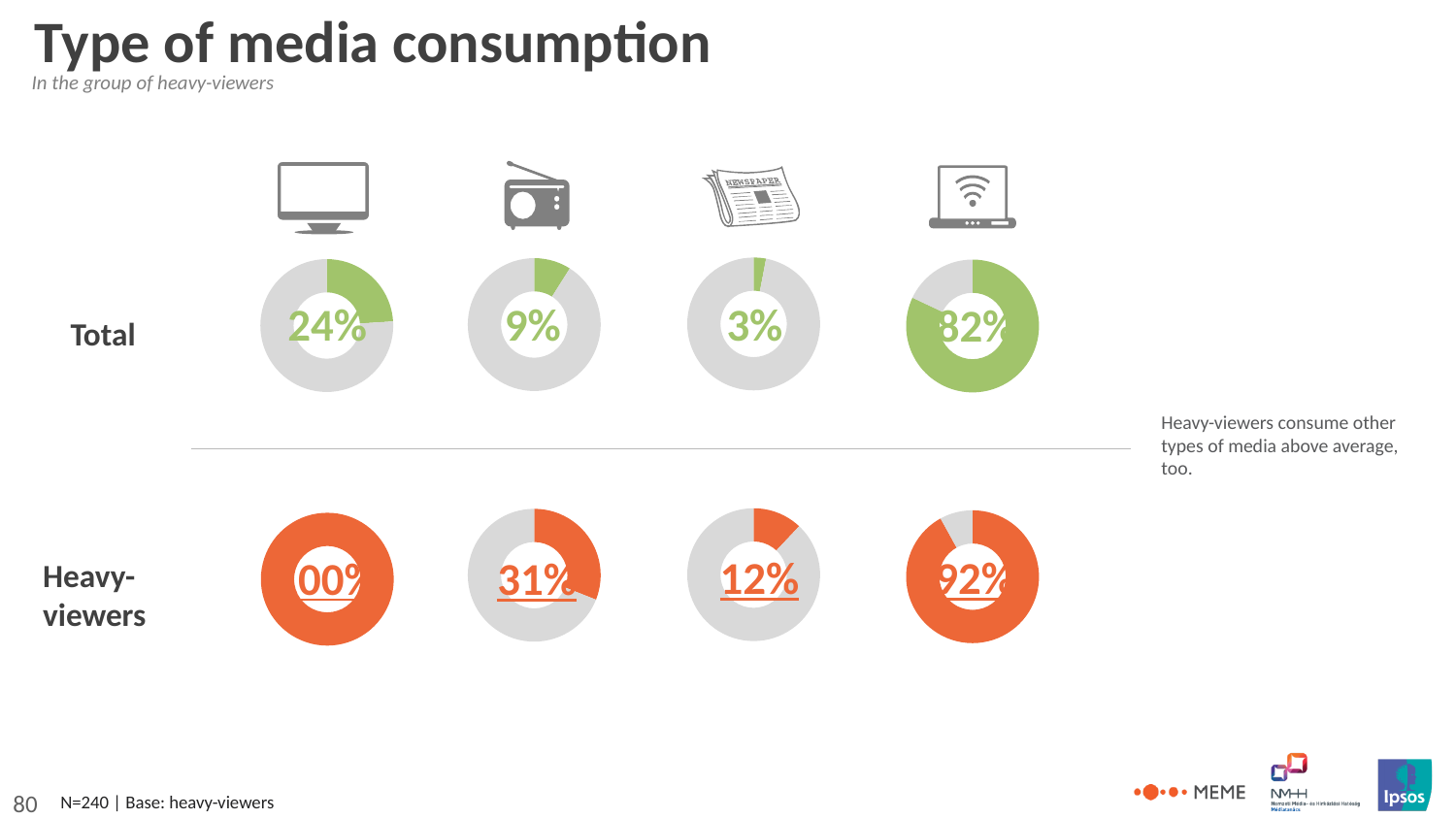
In the Total row, what percentage is shown in the donut chart under the newspaper icon? 3% In the Total row, what percentage is shown in the donut chart under the TV icon? 24% What is the difference between the Heavy-viewers and Total percentages for the laptop (internet) icon? 10 percentage points In the Total row, what percentage is shown in the donut chart under the radio icon? 9% In the Total row, what percentage is shown in the donut chart under the laptop (internet) icon? 82% In the Heavy-viewers row, what percentage is shown in the donut chart under the laptop (internet) icon? 92% In the Total row, which media type has the lowest percentage? Newspaper What is the difference between the Heavy-viewers and Total percentages for radio? 22 percentage points In the Total row, which media type has the highest percentage? Internet (laptop) What kind of chart is used to show each percentage on the slide? Donut (pie) chart In the Heavy-viewers row, what percentage is shown in the donut chart under the newspaper icon? 12% In the Heavy-viewers row, what percentage is shown in the donut chart under the radio icon? 31%